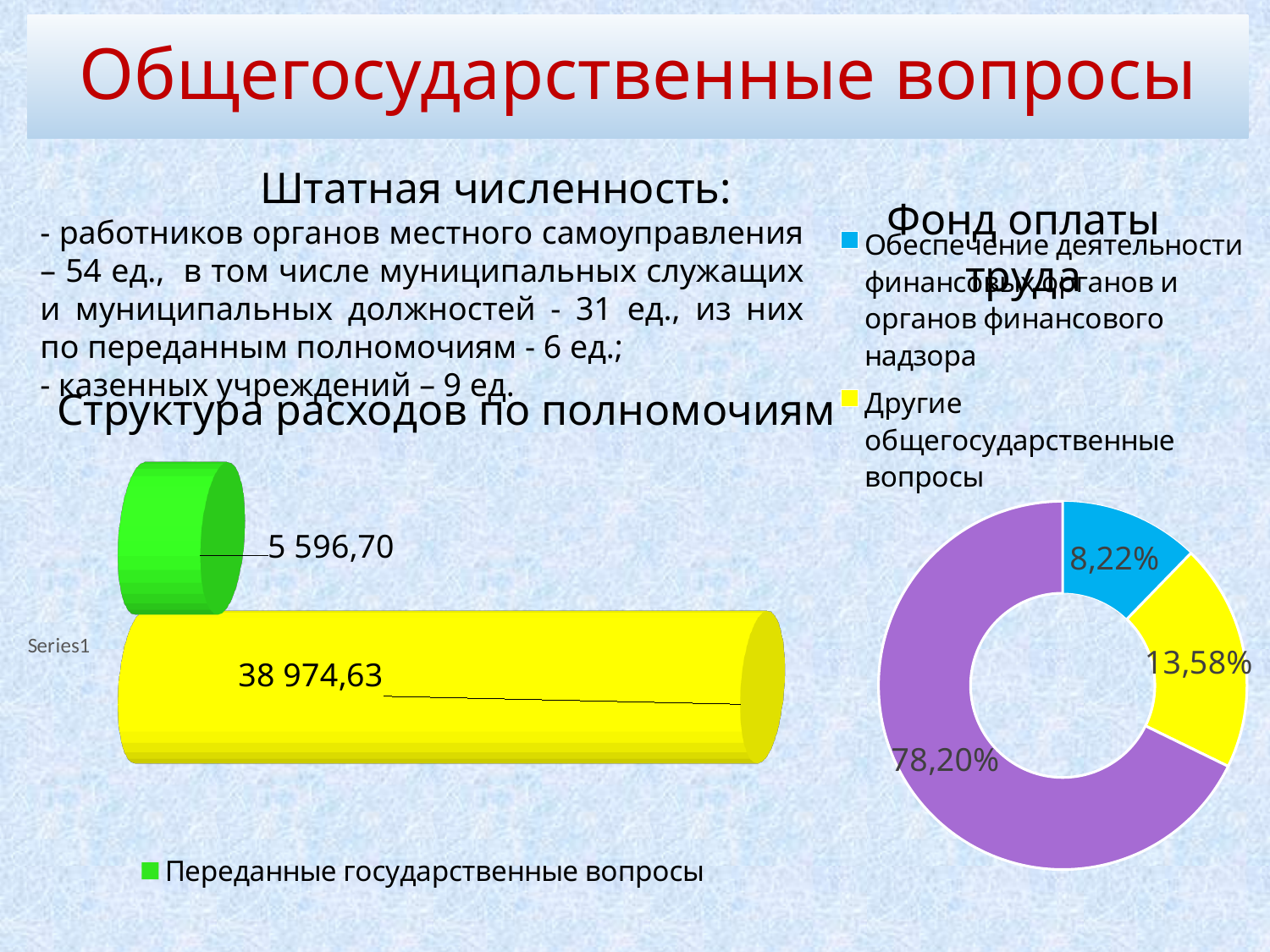
What kind of chart is 'Структура расходов по полномочиям'? bar chart On the bar chart 'Структура расходов по полномочиям', how many bars are plotted? 2 On the doughnut chart 'Фонд оплаты труда', what share is shown for 'Другие общегосударственные вопросы'? 13,58% On the doughnut chart 'Фонд оплаты труда', how many slices are there? 3 On the bar chart 'Структура расходов по полномочиям', which bar is larger, the green one or the yellow one? the yellow one On the doughnut chart 'Фонд оплаты труда', what is the largest share shown? 78,20% On the doughnut chart 'Фонд оплаты труда', what colour is the slice for 'Другие общегосударственные вопросы'? yellow On the bar chart 'Структура расходов по полномочиям', what is the value of the green bar for 'Переданные государственные вопросы'? 5 596,70 On the bar chart 'Структура расходов по полномочиям', what is the value printed on the yellow bar? 38 974,63 On the bar chart 'Структура расходов по полномочиям', what is the difference between the yellow bar value and the green bar value? 33 377,93 On the doughnut chart 'Фонд оплаты труда', what share is shown for 'Обеспечение деятельности финансовых органов и органов финансового надзора'? 8,22% On the doughnut chart 'Фонд оплаты труда', which slice is the smallest? Обеспечение деятельности финансовых органов и органов финансового надзора